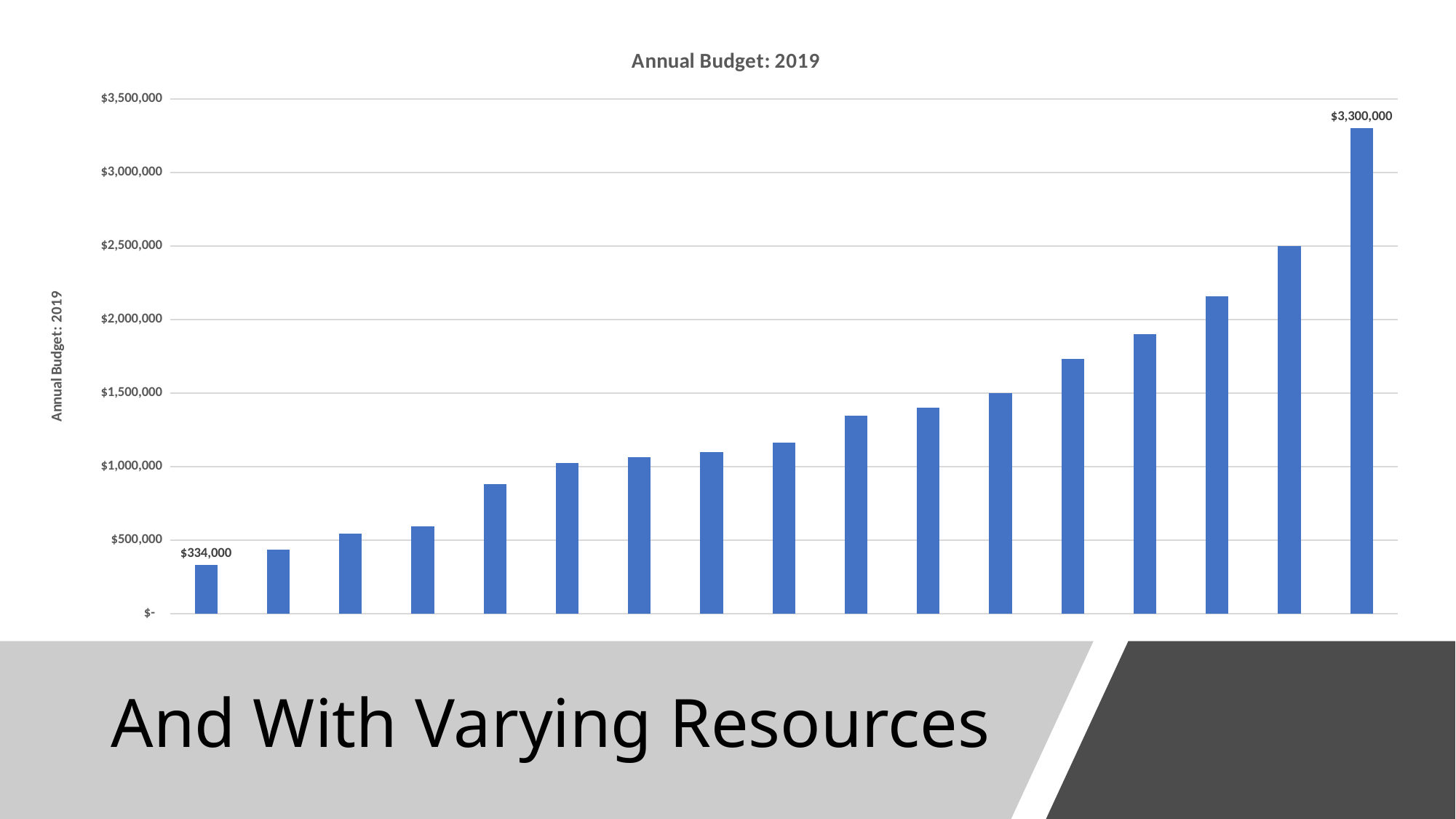
What is the difference between the rightmost bar and the leftmost bar? $2,966,000 What is the value labelled on the rightmost bar? $3,300,000 Is the value of the second bar from the left greater or less than $500,000? less What is the value of the shortest bar in the chart? $334,000 What is the title of the chart? Annual Budget: 2019 Which bar is larger, the leftmost bar or the rightmost bar? the rightmost bar What is the value of the tallest bar in the chart? $3,300,000 What kind of chart is shown on the slide? bar chart Is the value of the second bar from the right greater or less than $2,000,000? greater Do the bar values rise or fall from left to right across the chart? rise How many bars are plotted in the chart? 17 What is the value labelled on the leftmost bar? $334,000